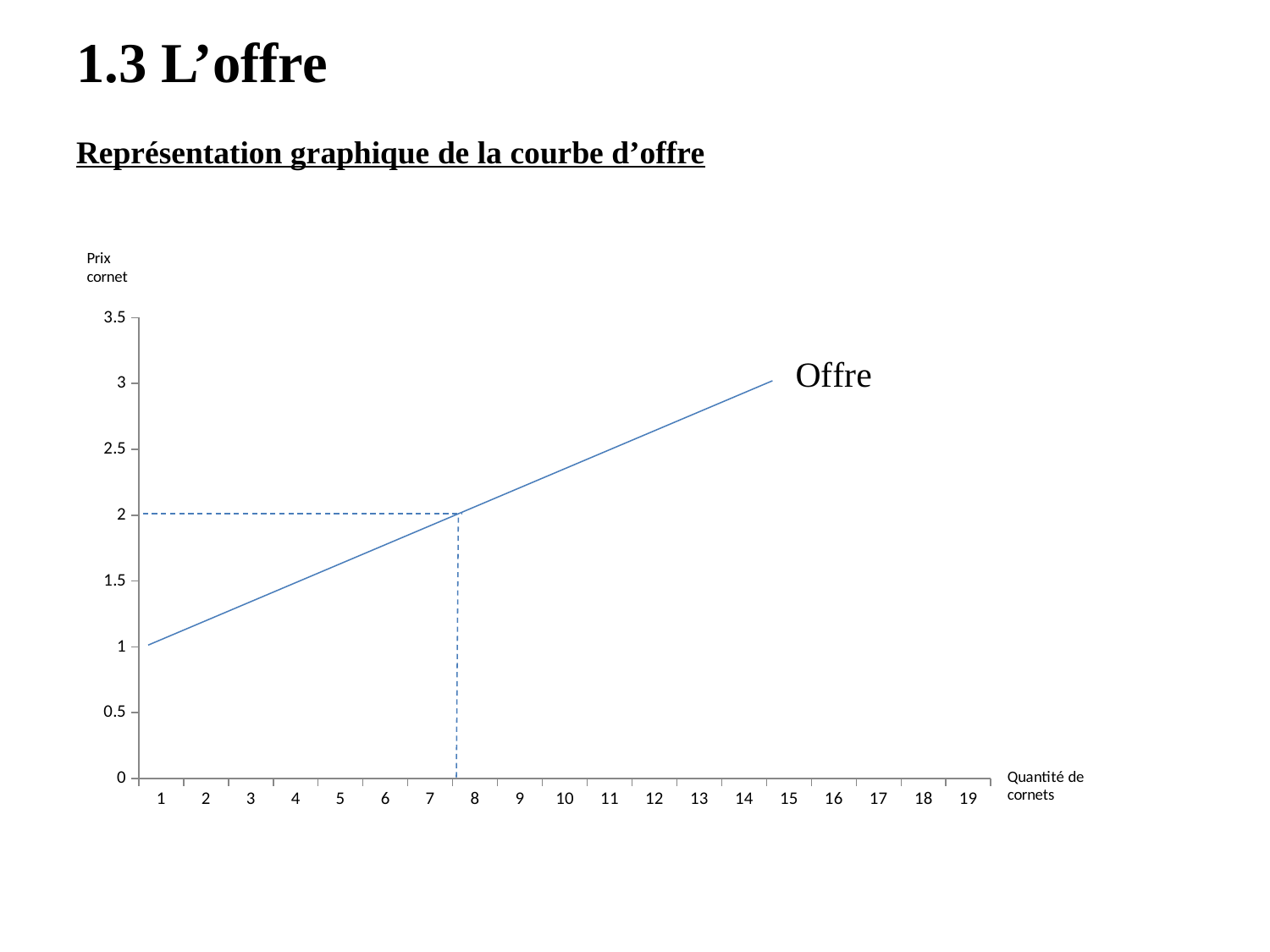
What is the label of the x axis? Quantité de cornets What is the price at the lowest point of the Offre curve? 1 What is the label of the curve plotted on the chart? Offre How many quantity values are marked on the x axis? 19 Is the price on the Offre curve at a quantity of 12 greater or less than 2? greater Is the price on the Offre curve at a quantity of 4 greater or less than 2? less What kind of chart is shown on the slide? line chart At what price level is the horizontal dashed line drawn? 2 Does the price rise or fall as the quantity of cornets increases along the x axis? rises Is the price on the Offre curve at a quantity of 2 greater or less than 1.5? less What is the highest value shown on the price (y) axis? 3.5 What is the price at the highest point of the Offre curve? 3